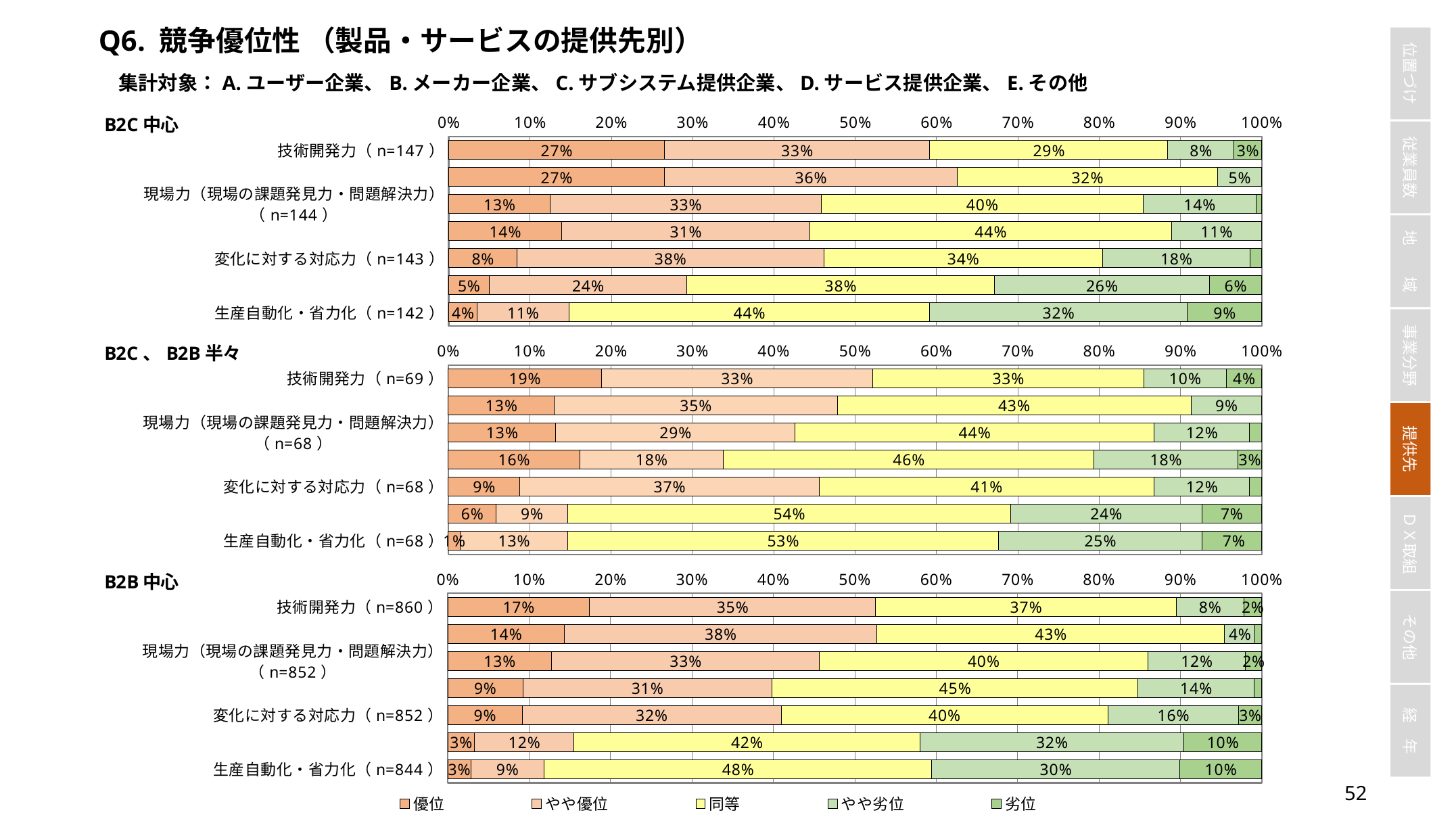
What kind of chart is used on this slide? Stacked bar chart In the B2C 、 B2B 半々 chart, what is the difference between the 同等 value for 生産自動化・省力化 (n=68) and the 同等 value for 技術開発力 (n=69)? 20% How many series does the legend list? 5 In the B2C 中心 chart, what is the difference between the やや劣位 value for 生産自動化・省力化 (n=142) and the やや劣位 value for 技術開発力 (n=147)? 24% In the B2C 中心 chart, which labeled category has the highest 優位 value? 技術開発力 (n=147) In the B2B 中心 chart, what is the 劣位 value for 生産自動化・省力化 (n=844)? 10% What is the first legend entry shown at the bottom of the slide? 優位 In the B2B 中心 chart, what is the 同等 value for 技術開発力 (n=860)? 37% In the B2B 中心 chart, which is larger: the 同等 value for 生産自動化・省力化 (n=844) or the 同等 value for 技術開発力 (n=860)? 生産自動化・省力化 (n=844) In the B2C 、 B2B 半々 chart, what is the やや劣位 value for 生産自動化・省力化 (n=68)? 25% In the B2C 中心 chart, what is the 同等 value for 生産自動化・省力化 (n=142)? 44% In the B2C 中心 chart, what is the 優位 value for 技術開発力 (n=147)? 27%